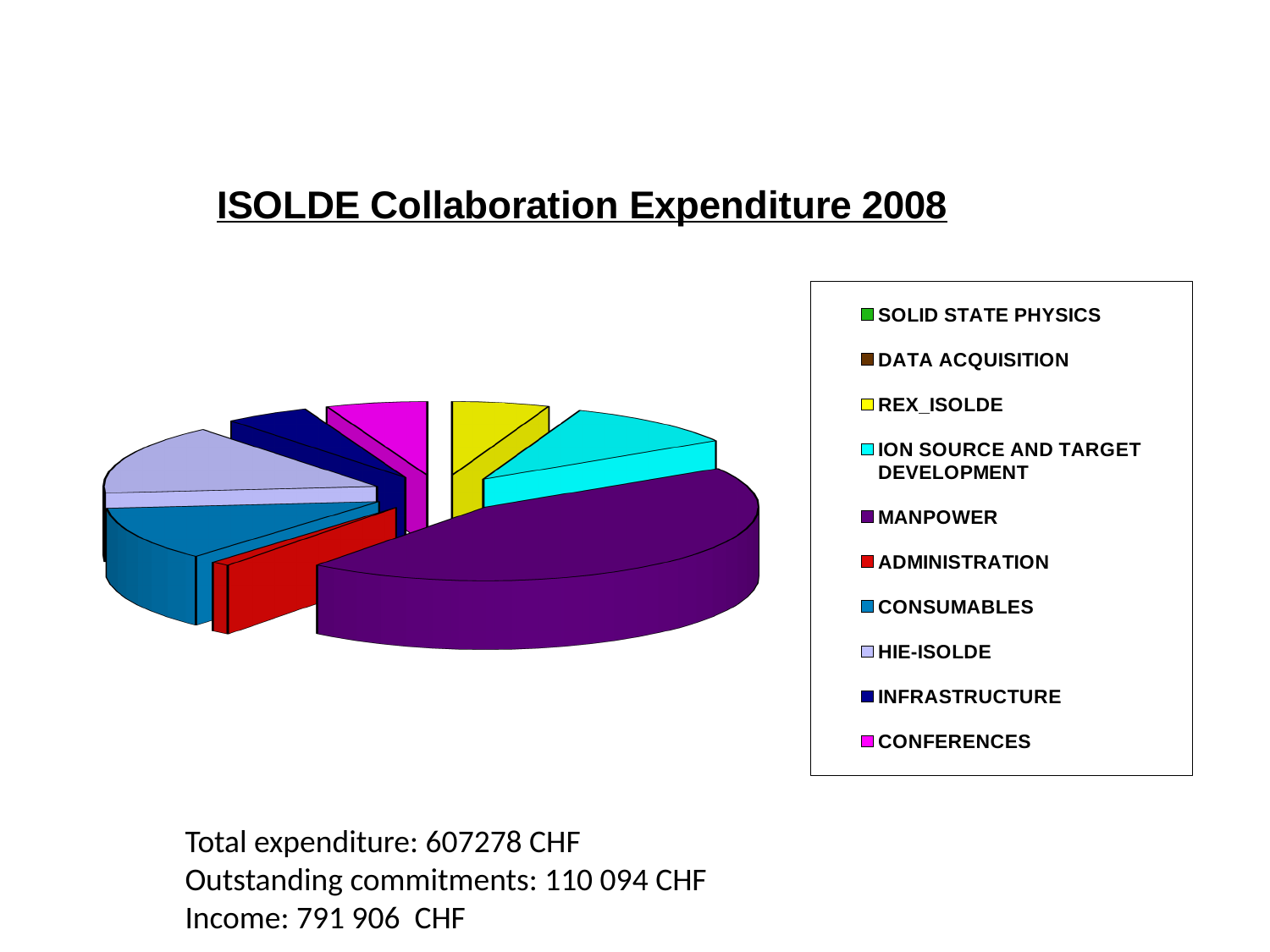
Which slice is larger, HIE-ISOLDE or INFRASTRUCTURE? HIE-ISOLDE What kind of chart is shown on the slide? Pie chart How many categories does the legend of the pie chart list? 10 What is the title of the chart? ISOLDE Collaboration Expenditure 2008 Which slice is larger, MANPOWER or ADMINISTRATION? MANPOWER Which category has the largest slice of the pie? MANPOWER Which slice is larger, CONSUMABLES or CONFERENCES? CONSUMABLES What colour is the MANPOWER slice in the pie chart? Purple